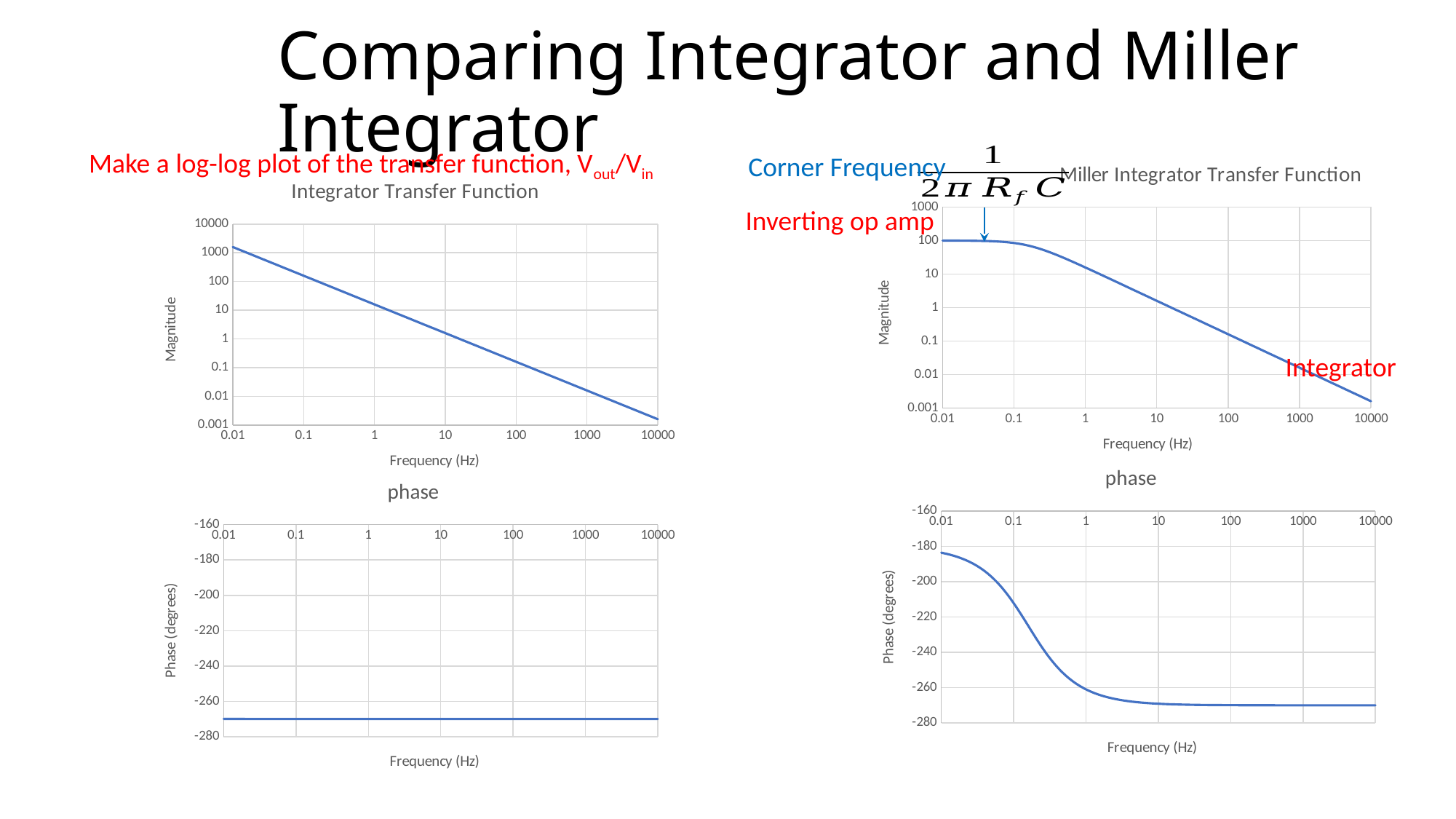
In the Integrator Transfer Function chart, is the magnitude at 0.01 Hz greater or less than 100? greater In the bottom-right phase chart, does the phase rise or fall as frequency increases? fall In the Integrator Transfer Function chart, does the magnitude rise or fall as frequency increases? fall What is the x-axis label of the Miller Integrator Transfer Function chart? Frequency (Hz) In the Miller Integrator Transfer Function chart, is the magnitude at 10000 Hz greater or less than 0.01? less In the Miller Integrator Transfer Function chart, is the magnitude at 0.01 Hz greater or less than 10? greater In the bottom-left phase chart, does the phase rise, fall, or stay flat as frequency increases? stay flat What kind of chart is the Integrator Transfer Function chart? line chart In the Miller Integrator Transfer Function chart, is the magnitude larger at 0.01 Hz or at 1000 Hz? 0.01 Hz